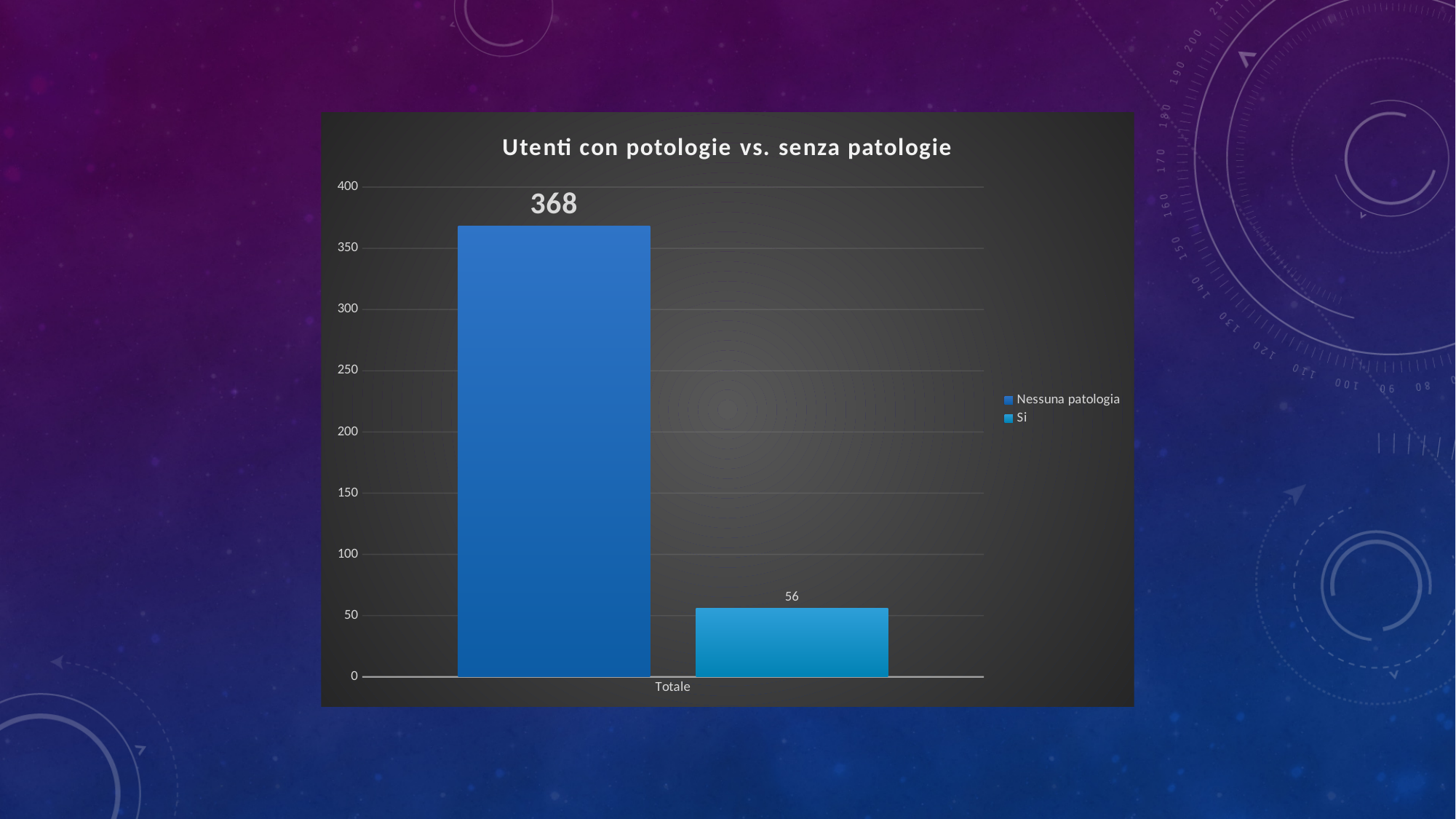
What is the value for Nessuna patologia? 368 Is the value for Si greater or less than 100? less What is the category label on the x axis? Totale Is the value for Nessuna patologia greater or less than 350? greater What is the difference between the values for Nessuna patologia and Si? 312 Which series has the lowest value? Si Which is larger, the value for Nessuna patologia or the value for Si? Nessuna patologia How many series does the legend list? 2 What is the title of the chart? Utenti con potologie vs. senza patologie What is the value for Si? 56 Which series has the highest value? Nessuna patologia What kind of chart is shown on the slide? bar chart